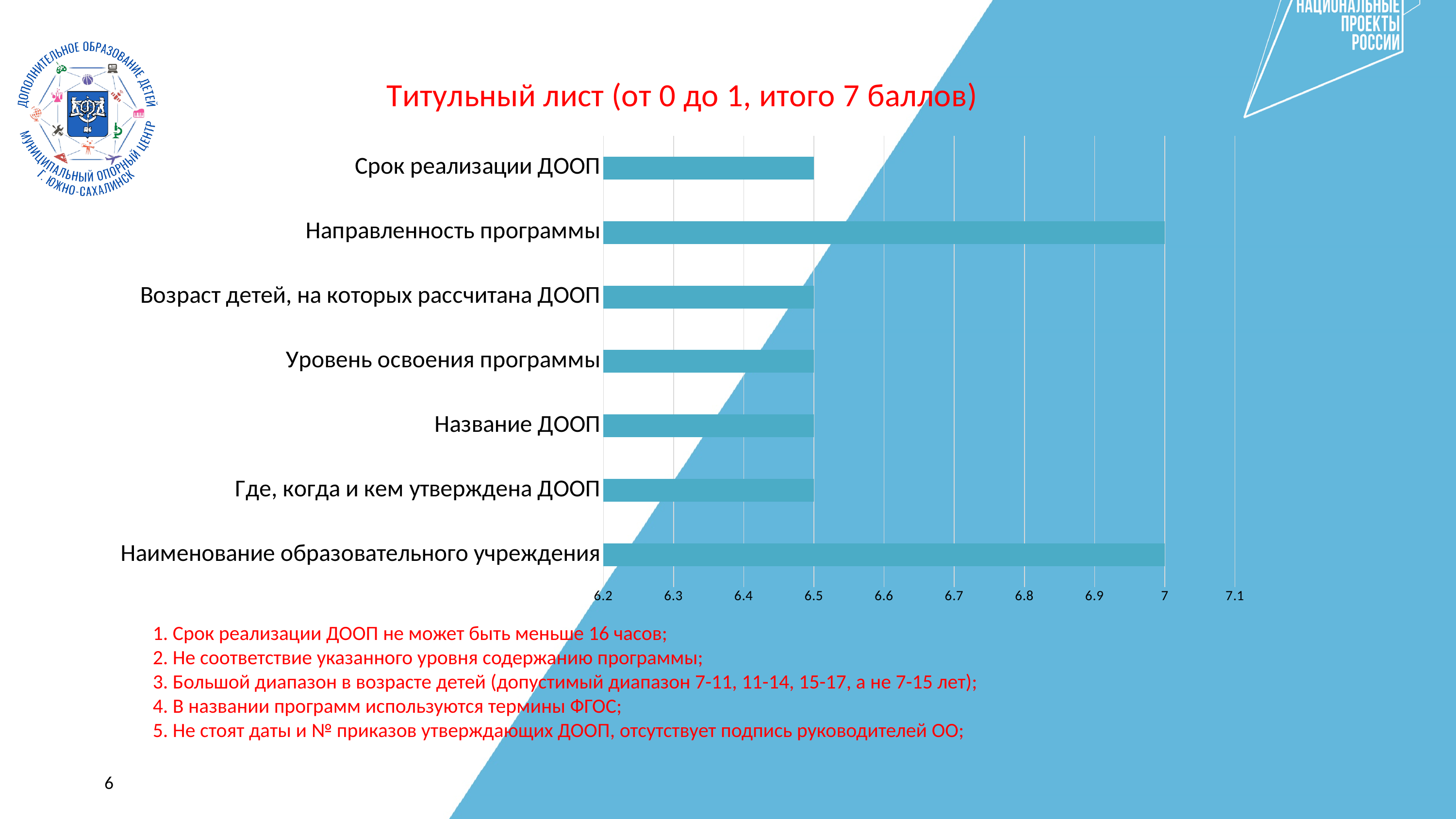
What is the value for Наименование образовательного учреждения? 7 Which is larger, the value for Направленность программы or the value for Уровень освоения программы? Направленность программы What is the value for Название ДООП? 6.5 How many categories are plotted in the chart? 7 What kind of chart is shown on the slide? bar chart What is the title of the chart? Титульный лист (от 0 до 1, итого 7 баллов) What is the difference between the value for Направленность программы and the value for Возраст детей, на которых рассчитана ДООП? 0.5 What is the value for Направленность программы? 7 What is the value for Срок реализации ДООП? 6.5 Is the value for Наименование образовательного учреждения greater or less than 6.6? greater Which is larger, the value for Где, когда и кем утверждена ДООП or the value for Наименование образовательного учреждения? Наименование образовательного учреждения Is the value for Возраст детей, на которых рассчитана ДООП greater or less than 6.8? less